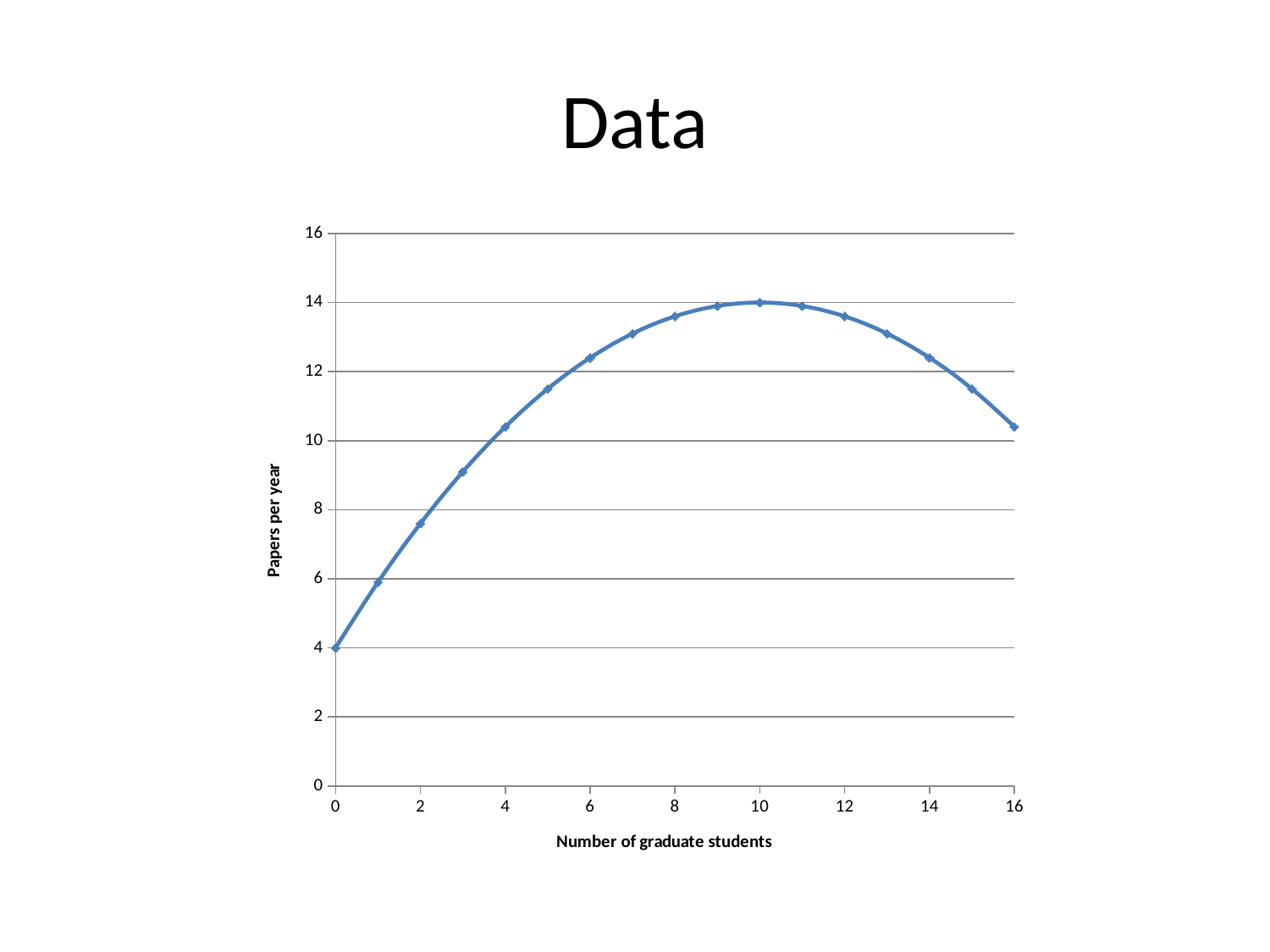
Is the value for 16 graduate students greater or less than 12? less Which has more papers per year: 2 graduate students or 14 graduate students? 14 graduate students At which number of graduate students is papers per year highest? 10 Is the value for 2 graduate students greater or less than 8? less Is the value for 6 graduate students greater or less than 12? greater What is the value of papers per year when the number of graduate students is 0? 4 How many data points are plotted on the chart? 17 At which number of graduate students is papers per year lowest? 0 How do papers per year change as the number of graduate students increases from 0 to 16? rise to a peak at 10, then fall What is the label of the x axis? Number of graduate students What kind of chart is shown on the slide? line chart What is the value of papers per year when the number of graduate students is 10? 14